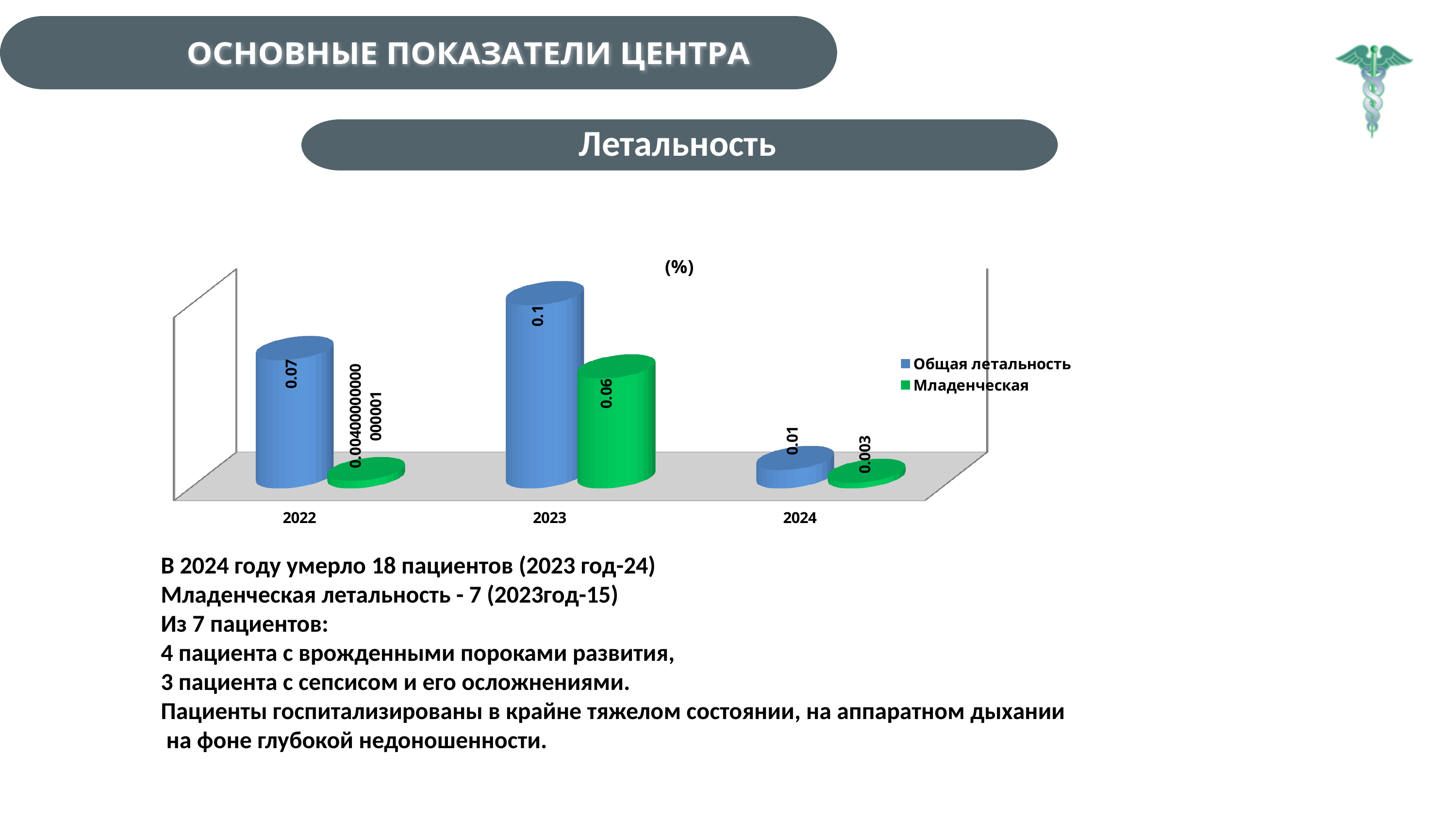
What is the value of Общая летальность for 2023? 0.1 What is the value of Общая летальность for 2024? 0.01 What is the difference between Общая летальность and Младенческая in 2023? 0.04 In which year is Младенческая lowest? 2024 How many years are shown on the x axis? 3 What is the value of Общая летальность for 2022? 0.07 In which year is Общая летальность highest? 2023 Which is larger in 2022: Общая летальность or Младенческая? Общая летальность How many series does the legend list? 2 What is the value of Младенческая for 2024? 0.003 What type of chart is shown on the slide? Bar chart What is the value of Младенческая for 2023? 0.06